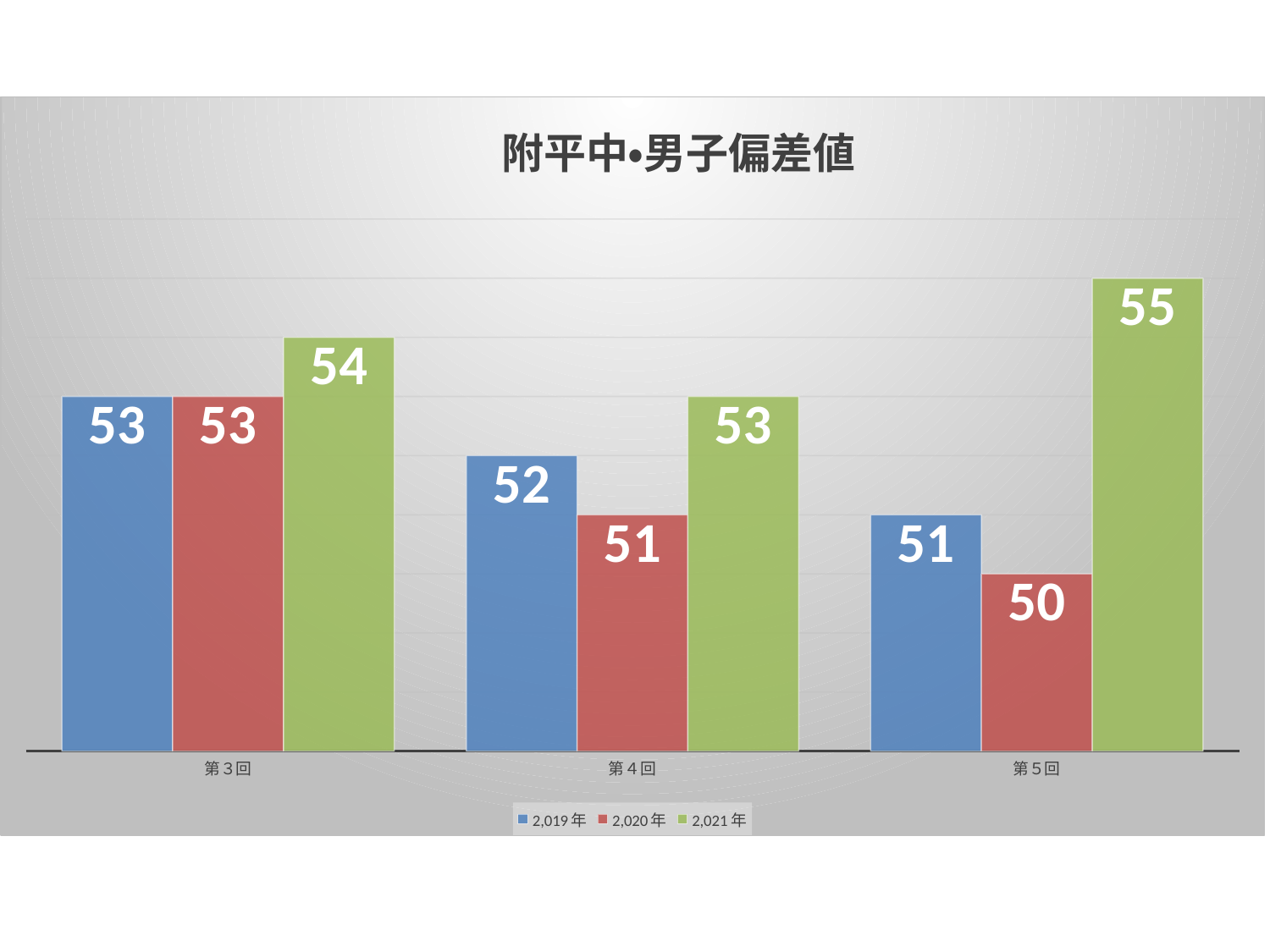
Which is larger at 第4回: the 2,019年 value or the 2,021年 value? 2,021年 What is the value for 2,019年 at 第3回? 53 How many series does the legend list? 3 What is the value for 2,021年 at 第5回? 55 What is the difference between the 2,021年 and 2,020年 values at 第5回? 5 What is the title of the chart? 附平中•男子偏差値 Do the values for the 2,019年 series rise or fall from 第3回 to 第5回? fall How many categories are shown on the x axis? 3 What kind of chart is shown on the slide? bar chart What is the value for 2,020年 at 第4回? 51 Which category has the lowest value for the 2,020年 series? 第5回 Which category has the highest value for the 2,021年 series? 第5回